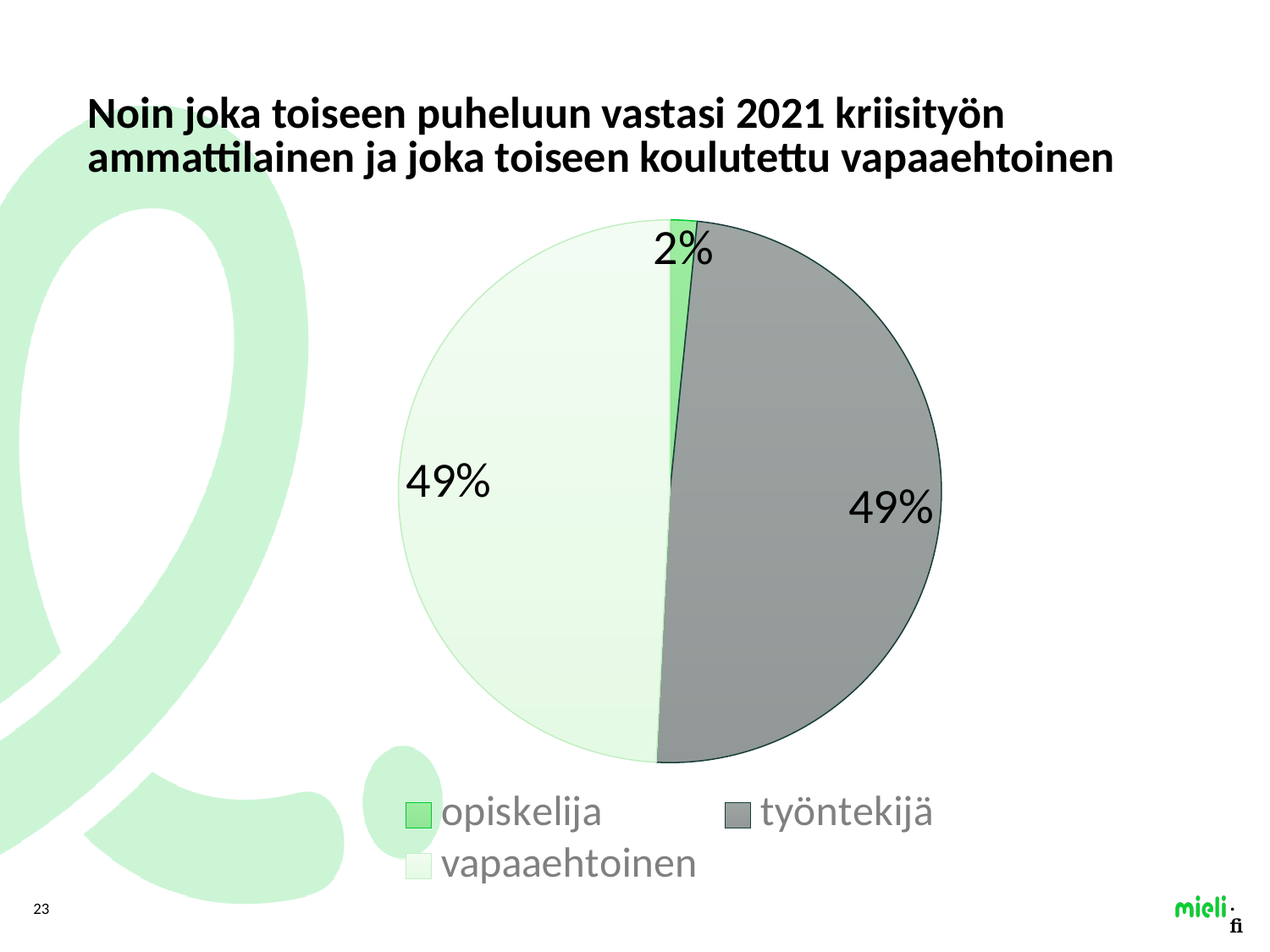
What share of the pie does the opiskelija slice represent? 2% How many entries does the legend list? 3 Which category has the smallest slice of the pie? opiskelija Which legend entry is shown with a bright green colour? opiskelija Which slice is larger, vapaaehtoinen or opiskelija? vapaaehtoinen Is the share for opiskelija greater or less than 10%? less What colour is the työntekijä slice in the pie chart? grey What kind of chart is shown on the slide? pie chart What share of the pie does the työntekijä slice represent? 49% What is the difference in percentage points between the työntekijä slice and the opiskelija slice? 47 percentage points What share of the pie does the vapaaehtoinen slice represent? 49% How many slices does the pie chart have? 3